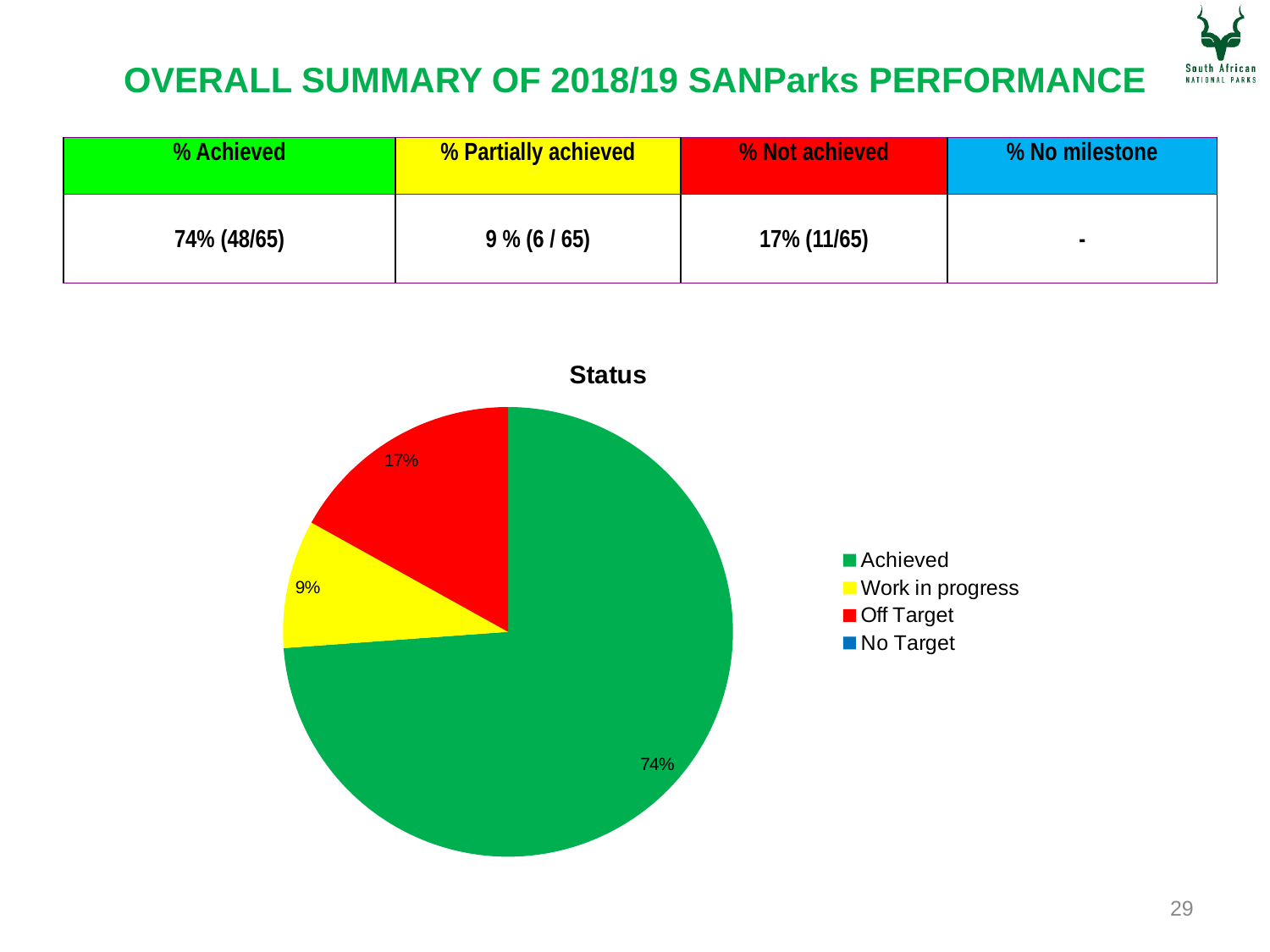
What share of the pie does the Off Target slice represent? 17% What is the difference in percentage points between the Achieved slice and the Off Target slice? 57 What share of the pie does the Achieved slice represent? 74% What is the difference in percentage points between the Off Target slice and the Work in progress slice? 8 Which is larger, the Off Target slice or the Work in progress slice? Off Target How many entries does the legend list? 4 What colour is the Achieved slice? green Which category with a visible slice has the smallest share of the pie? Work in progress What is the title of the chart? Status What share of the pie does the Work in progress slice represent? 9% Which category has the largest slice of the pie? Achieved What kind of chart is shown on the slide? pie chart